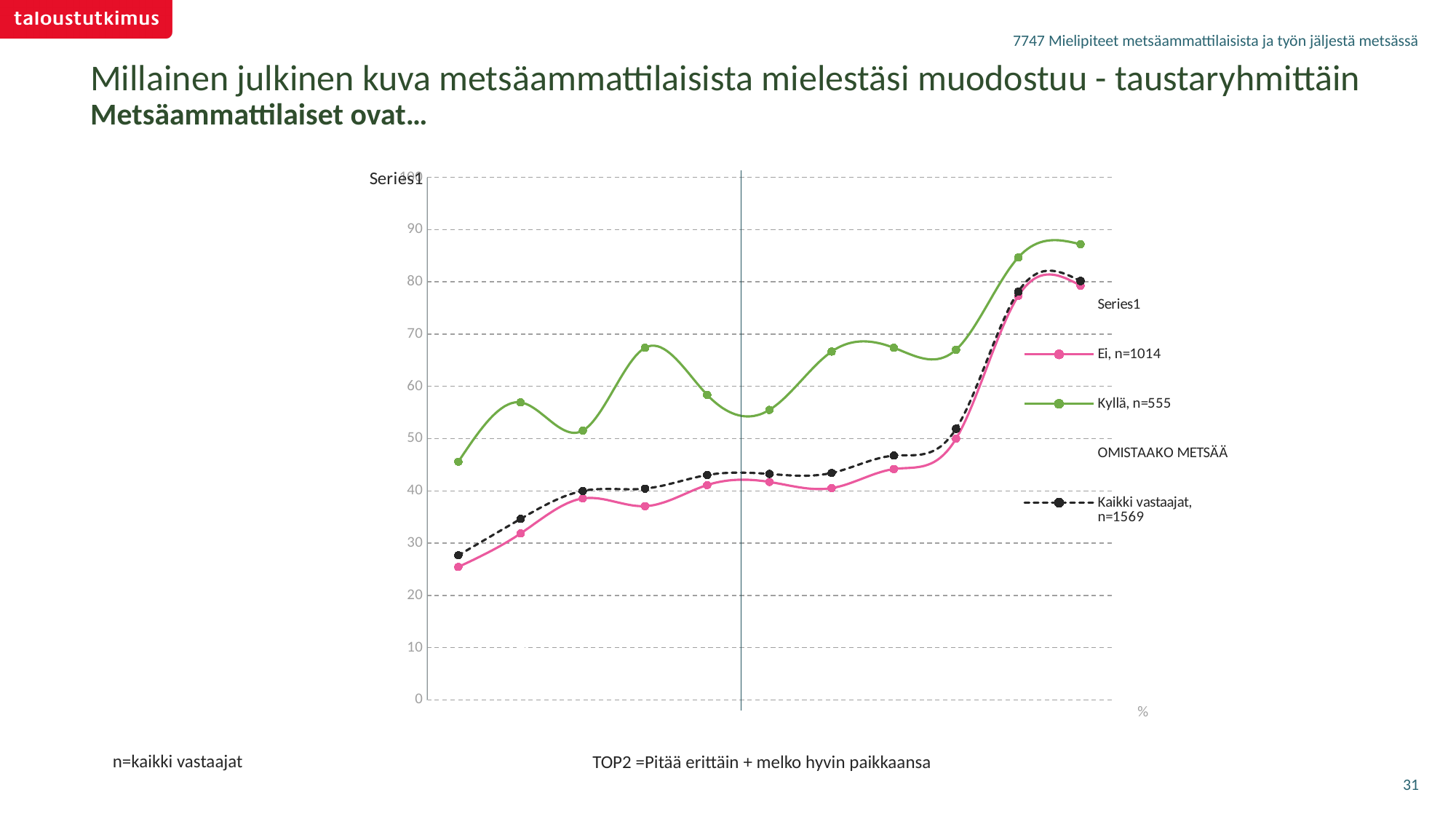
Is the rightmost value for "Kyllä, n=555" greater or less than 80? greater Is the leftmost value for "Ei, n=1014" greater or less than 30? less At the leftmost point, which is larger: the value for "Kyllä, n=555" or the value for "Ei, n=1014"? Kyllä, n=555 Do the values of the "Kaikki vastaajat, n=1569" line generally rise or fall from left to right? rise How many data points does the "Kyllä, n=555" line have? 11 Which series has the lowest value at the leftmost point of the chart? Ei, n=1014 Which series has the highest value at the rightmost point of the chart? Kyllä, n=555 Is the leftmost value for "Kyllä, n=555" greater or less than 40? greater How many series does the legend list? 5 What unit symbol is shown at the bottom right of the chart's axis? % What kind of chart is shown on the slide? line chart